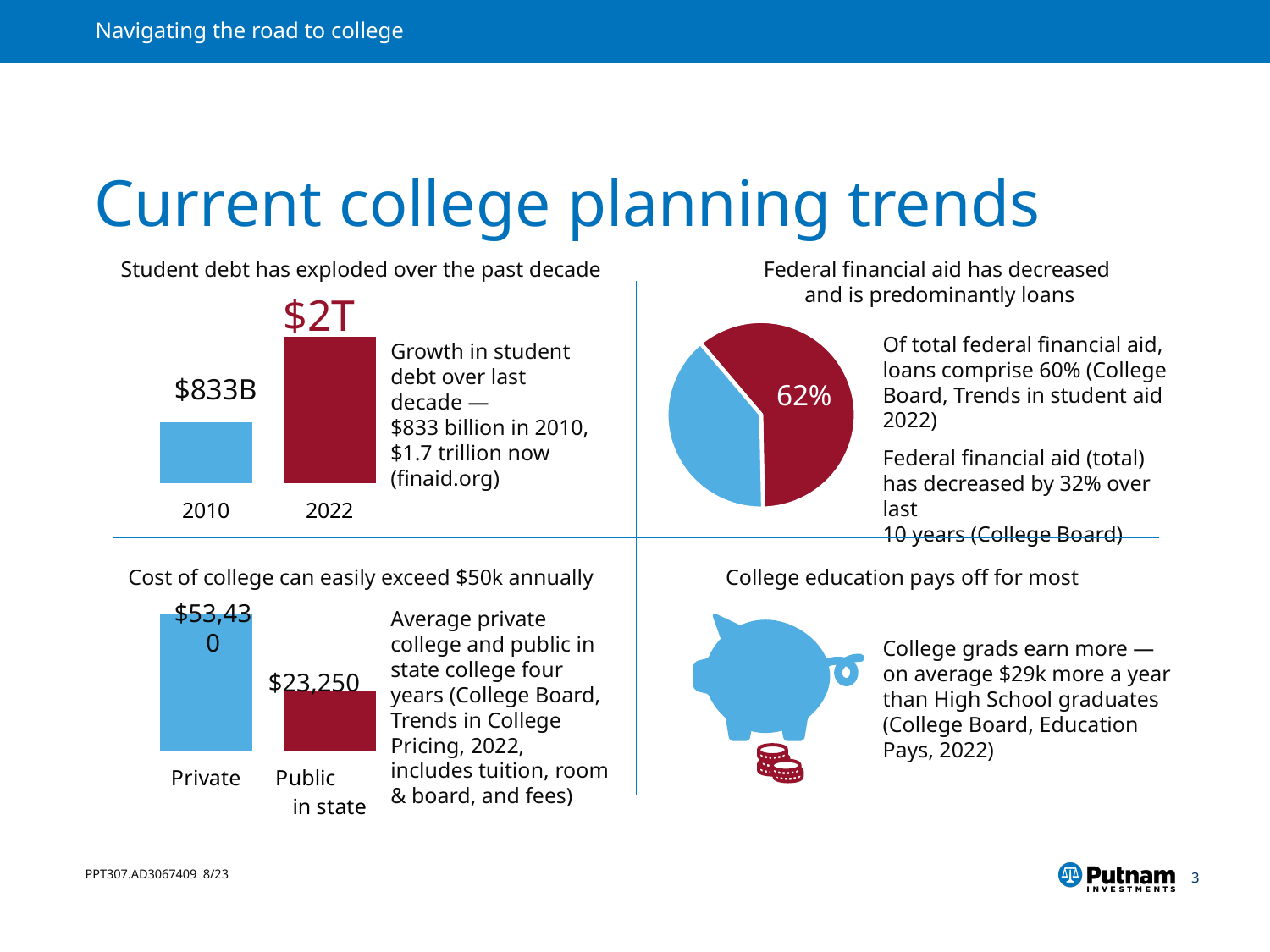
In the 'Student debt has exploded over the past decade' chart, which year has the higher bar? 2022 How many slices does the pie chart under 'Federal financial aid has decreased and is predominantly loans' have? 2 What kind of chart is used under 'Student debt has exploded over the past decade'? Bar chart In the 'Cost of college can easily exceed $50k annually' bar chart, what is the value for Public in state? $23,250 In the 'Cost of college can easily exceed $50k annually' bar chart, what is the difference between the Private and Public in state values? $30,180 In the 'Student debt has exploded over the past decade' bar chart, what is the value shown for 2010? $833B In the 'Student debt has exploded over the past decade' chart, do the values rise or fall from 2010 to 2022? Rise In the pie chart under 'Federal financial aid has decreased and is predominantly loans', what percentage is labeled on the red slice? 62% What kind of chart is shown under 'Federal financial aid has decreased and is predominantly loans'? Pie chart How many bars are in the 'Student debt has exploded over the past decade' chart? 2 In the 'Student debt has exploded over the past decade' bar chart, what is the value shown for 2022? $2T In the 'Cost of college can easily exceed $50k annually' bar chart, what is the value for Private? $53,430